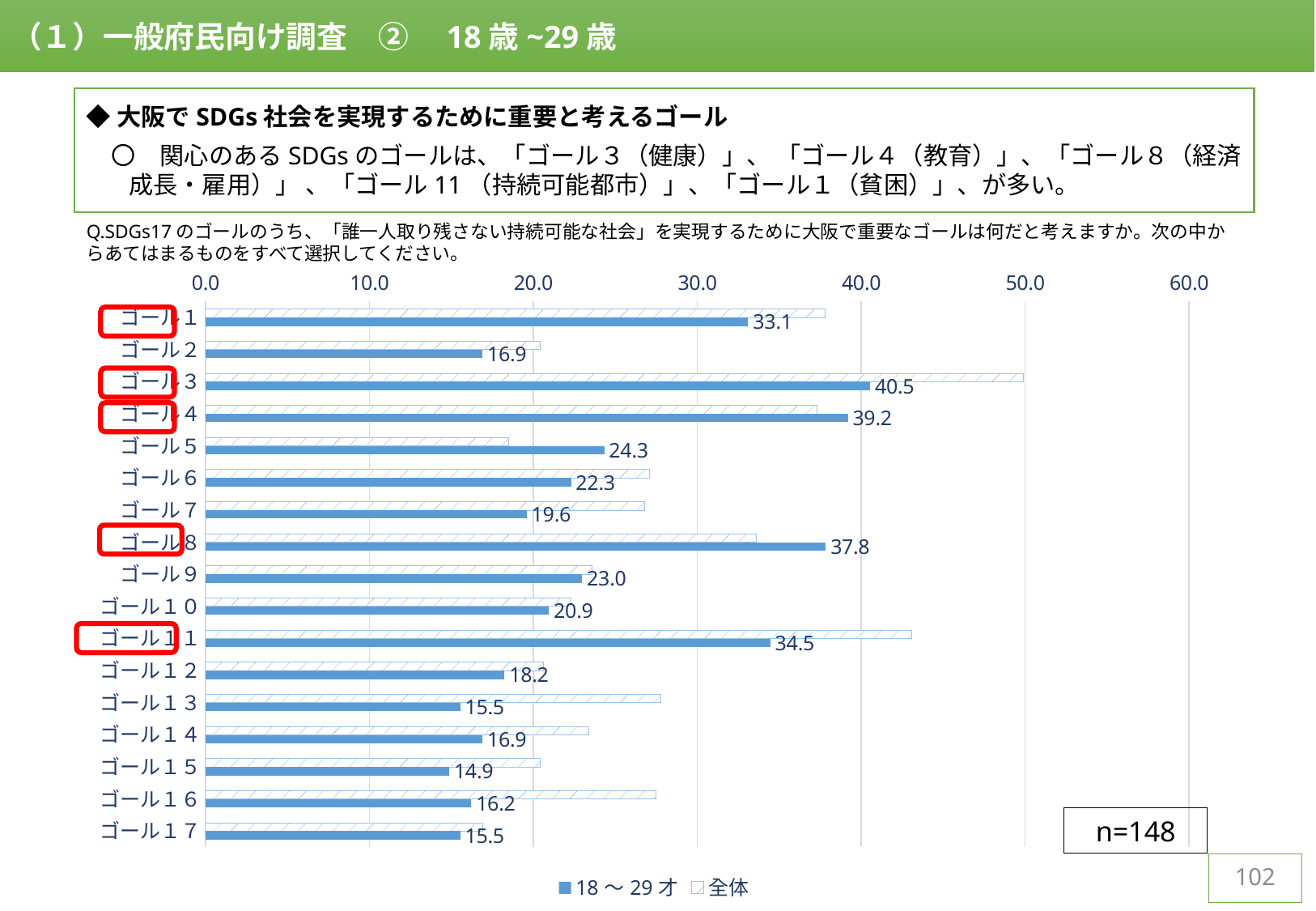
What is the value for ゴール３ in the 18～29才 series? 40.5 In the 18～29才 series, which is larger: ゴール４ or ゴール８? ゴール４ What kind of chart is shown on the slide? Bar chart How many series does the legend list? 2 Which goal has the lowest value in the 18～29才 series? ゴール１５ How many goal categories are shown on the chart? 17 Is the 全体 value for ゴール３ greater or less than 40.0? greater Is the 全体 value for ゴール１６ greater or less than 30.0? less What is the difference between the 18～29才 values for ゴール３ and ゴール１? 7.4 Which goal has the highest value in the 18～29才 series? ゴール３ What is the value for ゴール８ in the 18～29才 series? 37.8 What is the value for ゴール１１ in the 18～29才 series? 34.5